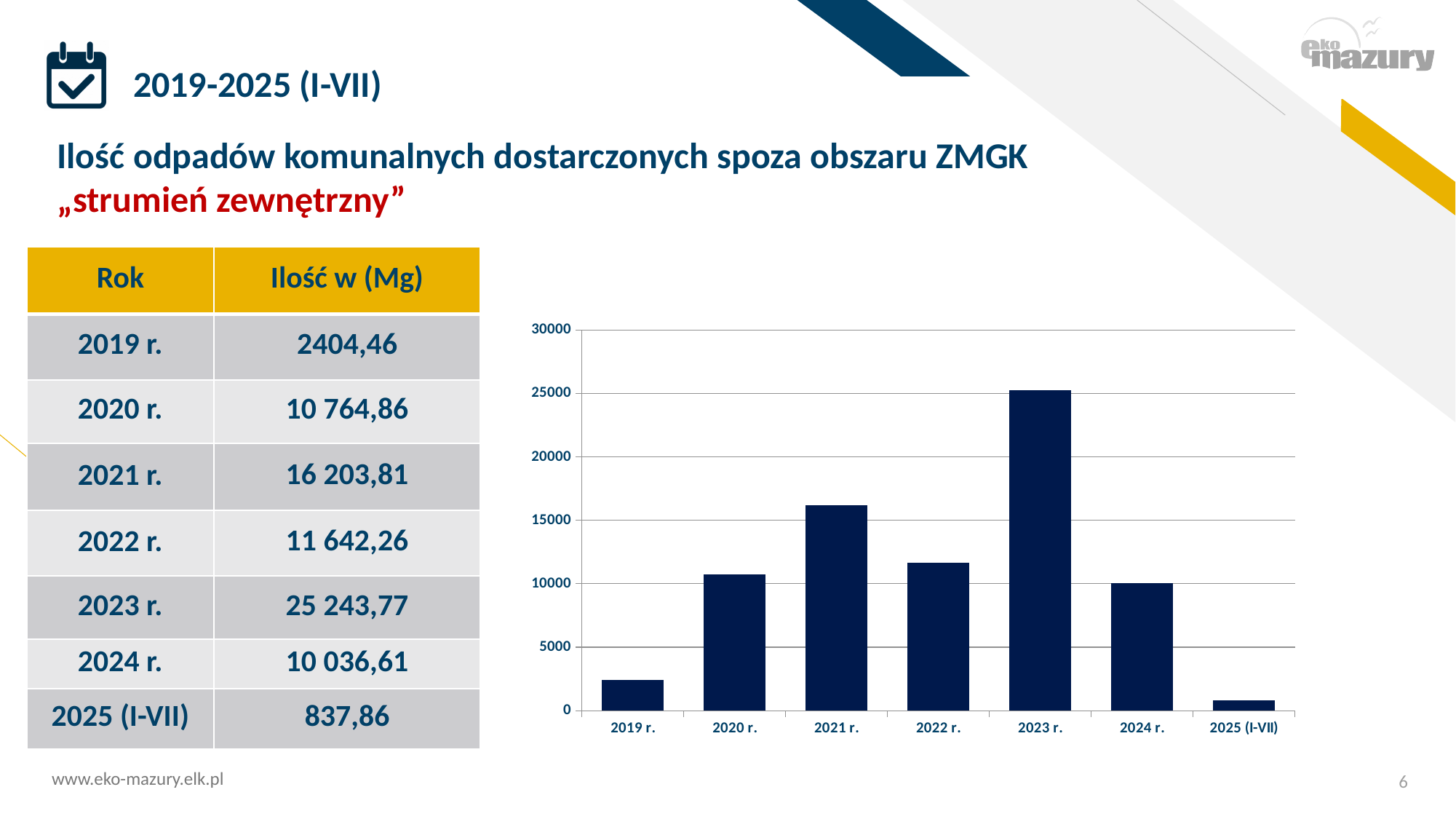
How many bars (years) does the chart show? 7 What is the highest tick value shown on the vertical axis of the chart? 30000 Is the value for 2021 r. greater or less than 15000? greater What is the difference between the values for 2021 r. and 2022 r.? 4 561,55 What is the value for 2019 r. according to the slide? 2404,46 Is the value for 2022 r. greater or less than 15000? less What kind of chart is shown on the slide? bar chart Which year has the highest value in the chart? 2023 r. Which category has the lowest value in the chart? 2025 (I-VII) Which is larger, the value for 2020 r. or the value for 2024 r.? 2020 r. What is the value for 2023 r. according to the slide? 25 243,77 What is the value for 2025 (I-VII) according to the slide? 837,86